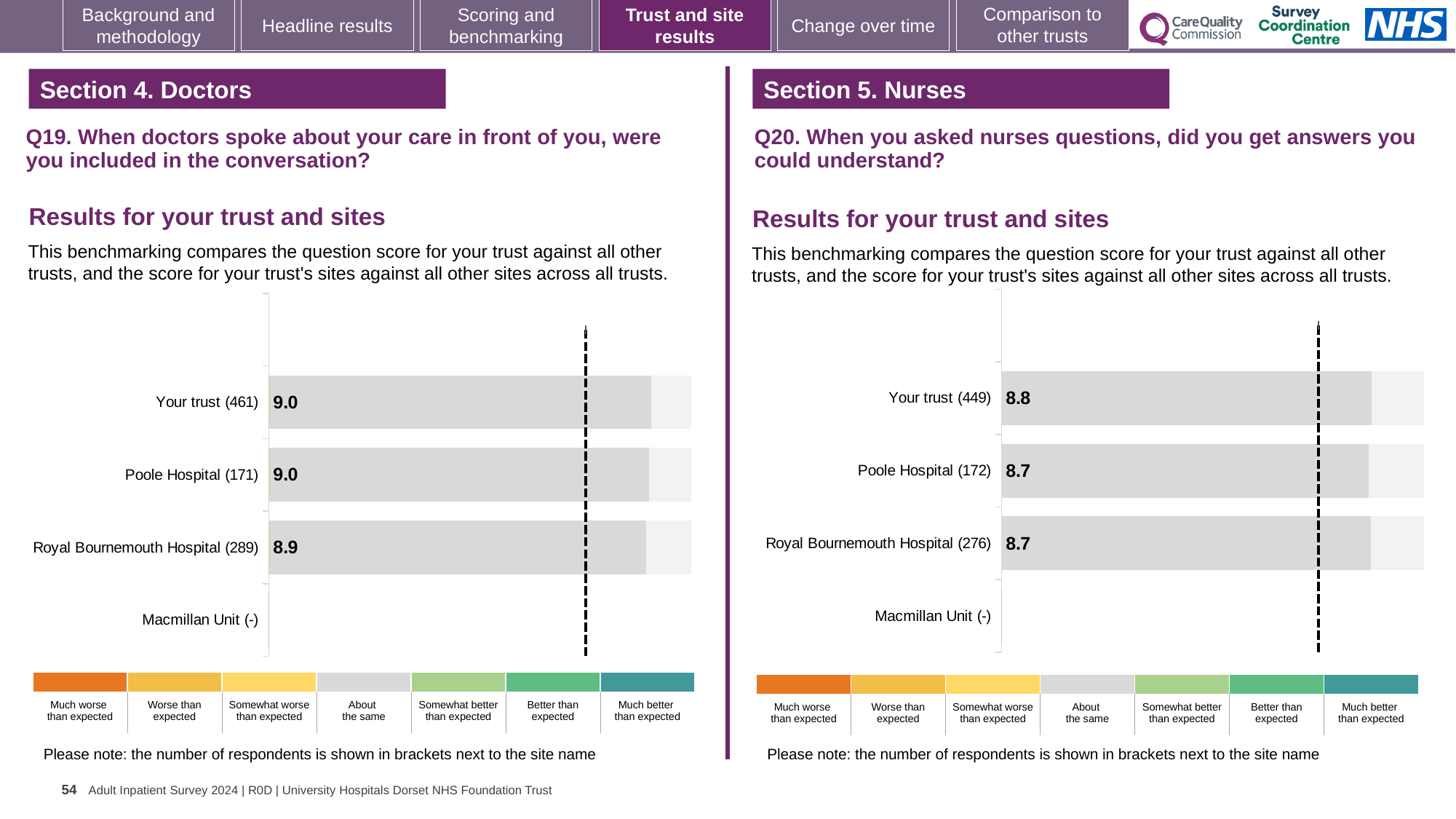
On the Q19 chart (Section 4. Doctors), what is the score for Your trust? 9.0 What kind of chart is used on the Q20 chart (Section 5. Nurses)? Bar chart On the Q20 chart (Section 5. Nurses), what is the difference between the score for Your trust and the score for Royal Bournemouth Hospital? 0.1 On the Q20 chart (Section 5. Nurses), what is the score for Your trust? 8.8 On the Q20 chart (Section 5. Nurses), which row has the highest score? Your trust On the Q20 chart (Section 5. Nurses), what is the score for Poole Hospital? 8.7 On the Q19 chart (Section 4. Doctors), what is the difference between the score for Poole Hospital and the score for Royal Bournemouth Hospital? 0.1 On the Q20 chart (Section 5. Nurses), how many respondents are shown in brackets for Royal Bournemouth Hospital? 276 On the Q19 chart (Section 4. Doctors), what is the score for Royal Bournemouth Hospital? 8.9 Which is larger: the Your trust score on the Q19 chart (Doctors) or the Your trust score on the Q20 chart (Nurses)? Q19 (Doctors), 9.0 On the Q19 chart (Section 4. Doctors), which site has the lowest score among those with a value shown? Royal Bournemouth Hospital On the Q19 chart (Section 4. Doctors), how many rows (sites including Your trust) are listed? 4